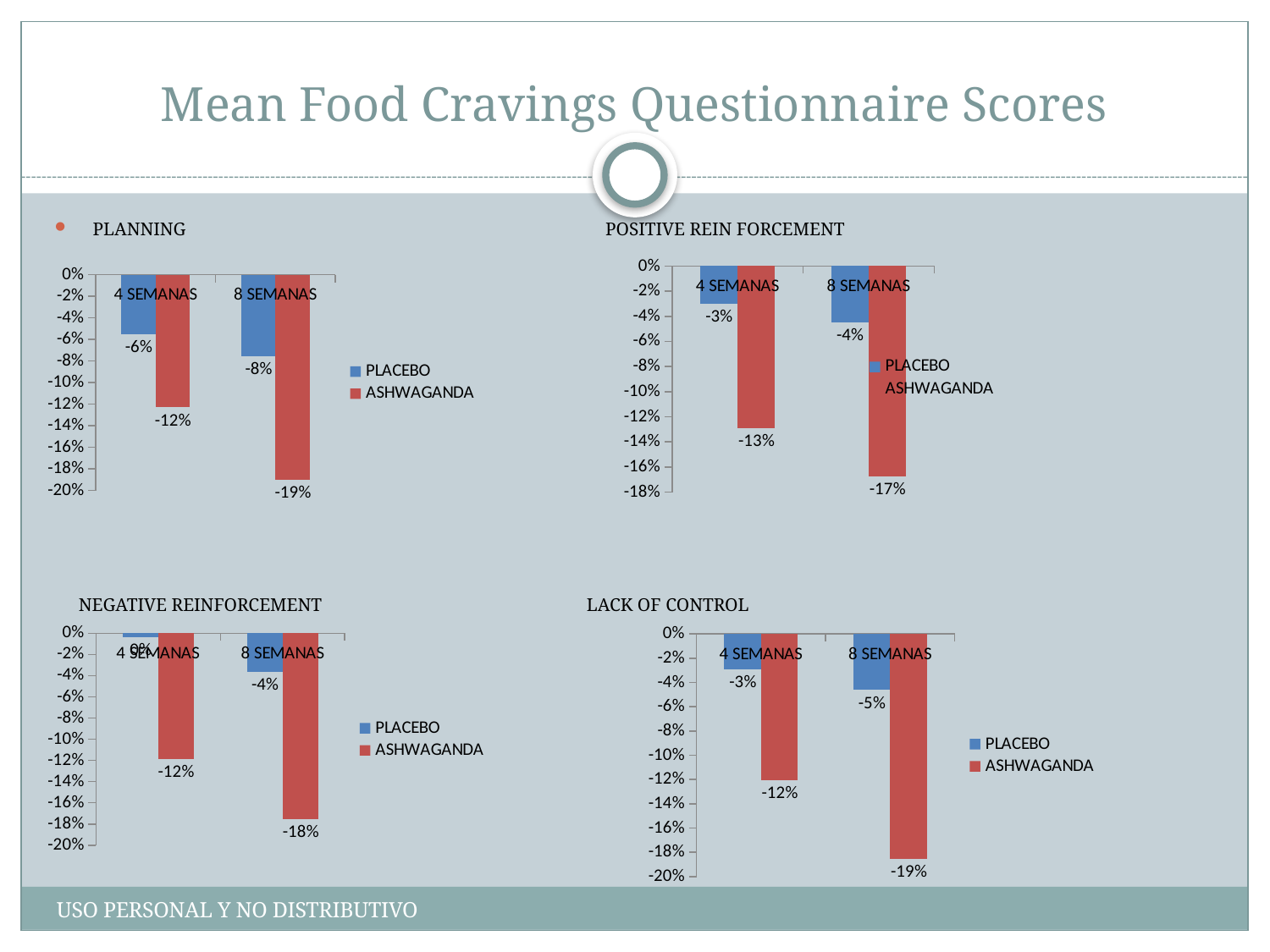
In the LACK OF CONTROL chart, what is the ASHWAGANDA value at 8 SEMANAS? -19% In the PLANNING chart, what is the ASHWAGANDA value at 8 SEMANAS? -19% In the NEGATIVE REINFORCEMENT chart, what is the PLACEBO value at 4 SEMANAS? 0% In the PLANNING chart, what is the PLACEBO value at 4 SEMANAS? -6% How many series does the legend of the POSITIVE REIN FORCEMENT chart list? 2 How many categories are shown on the x axis of the LACK OF CONTROL chart? 2 In the LACK OF CONTROL chart, what is the difference between the PLACEBO and ASHWAGANDA values at 8 SEMANAS? 14% In the PLANNING chart, which series has the lowest value at 8 SEMANAS? ASHWAGANDA What kind of chart is the NEGATIVE REINFORCEMENT chart? Bar chart In the POSITIVE REIN FORCEMENT chart, what is the PLACEBO value at 8 SEMANAS? -4% In the NEGATIVE REINFORCEMENT chart, which is lower at 8 SEMANAS, PLACEBO or ASHWAGANDA? ASHWAGANDA In the POSITIVE REIN FORCEMENT chart, what is the ASHWAGANDA value at 4 SEMANAS? -13%